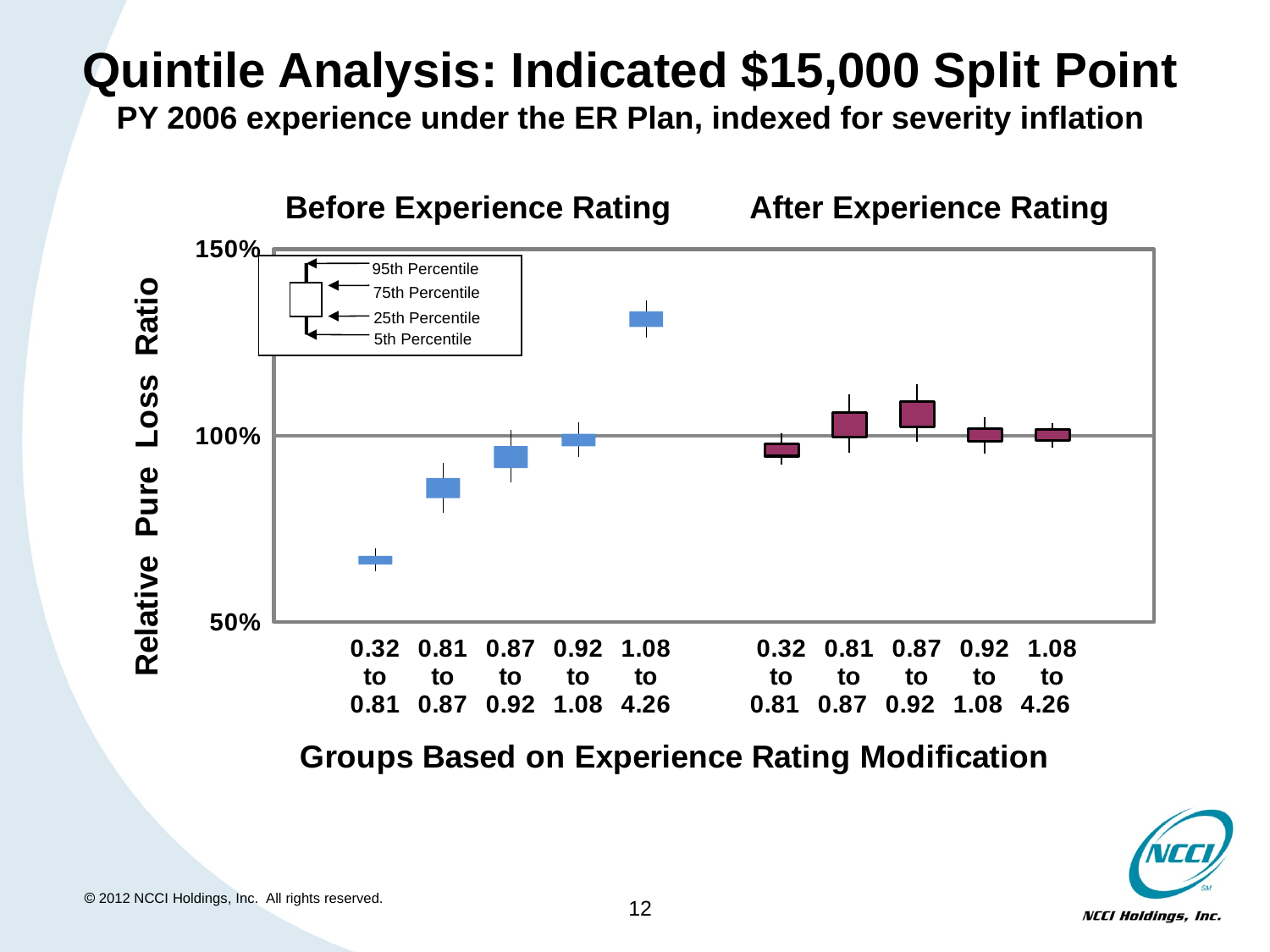
In the Before Experience Rating panel, which is larger: the value for the 0.81 to 0.87 group or the 1.08 to 4.26 group? 1.08 to 4.26 In the Before Experience Rating panel, is the value for the 1.08 to 4.26 group greater or less than 100%? greater In the After Experience Rating panel, which group has the lowest relative pure loss ratio? 0.32 to 0.81 In the Before Experience Rating panel, which group has the highest relative pure loss ratio? 1.08 to 4.26 In the Before Experience Rating panel, do the relative pure loss ratios rise or fall as the modification groups increase along the x axis? rise How many boxes are plotted in total across both panels? 10 In the Before Experience Rating panel, which group has the lowest relative pure loss ratio? 0.32 to 0.81 What is the label of the y axis? Relative Pure Loss Ratio In the Before Experience Rating panel, is the value for the 0.32 to 0.81 group greater or less than 100%? less Which percentile does the top whisker represent according to the legend? 95th Percentile What kind of chart is shown on the slide? Box plot How many experience rating modification groups are shown in the Before Experience Rating panel? 5